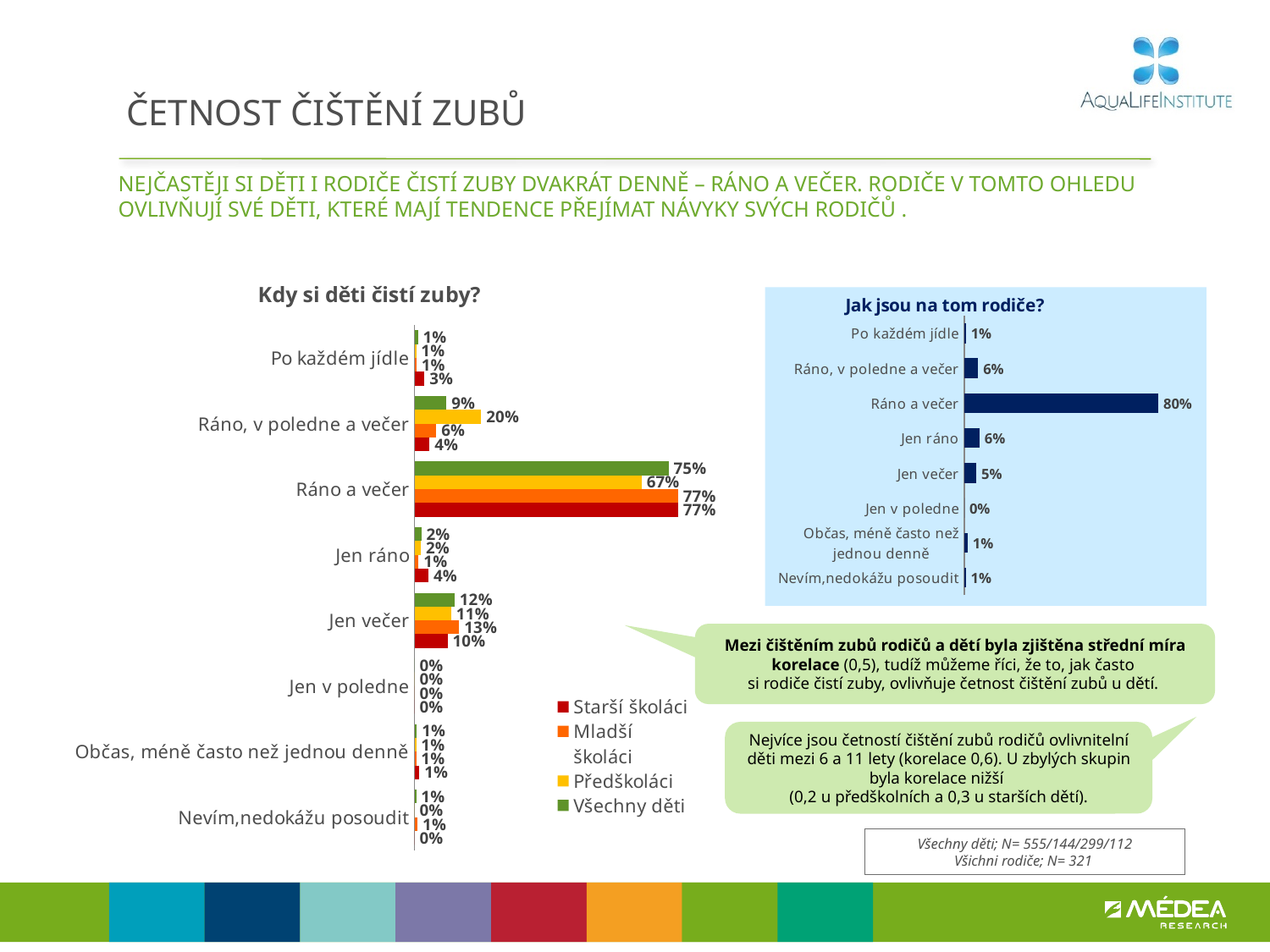
In the chart 'Jak jsou na tom rodiče?', which category has the highest value? Ráno a večer In the chart 'Kdy si děti čistí zuby?', what is the value for 'Všechny děti' in the category 'Ráno a večer'? 75% In the chart 'Jak jsou na tom rodiče?', how many categories are shown? 8 In the chart 'Kdy si děti čistí zuby?', which is larger for 'Jen večer': 'Mladší školáci' or 'Starší školáci'? Mladší školáci In the chart 'Jak jsou na tom rodiče?', what is the value for 'Ráno a večer'? 80% What type of chart is 'Kdy si děti čistí zuby?'? Bar chart In the chart 'Kdy si děti čistí zuby?', how many series does the legend list? 4 In the chart 'Kdy si děti čistí zuby?', what is the difference between 'Předškoláci' and 'Starší školáci' in the category 'Ráno, v poledne a večer'? 16% In the chart 'Jak jsou na tom rodiče?', what is the value for 'Jen večer'? 5% In the chart 'Jak jsou na tom rodiče?', what is the difference between 'Ráno a večer' and 'Ráno, v poledne a večer'? 74% In the chart 'Kdy si děti čistí zuby?', what is the value for 'Předškoláci' in the category 'Ráno, v poledne a večer'? 20% In the chart 'Kdy si děti čistí zuby?', what is the value for 'Starší školáci' in the category 'Jen ráno'? 4%